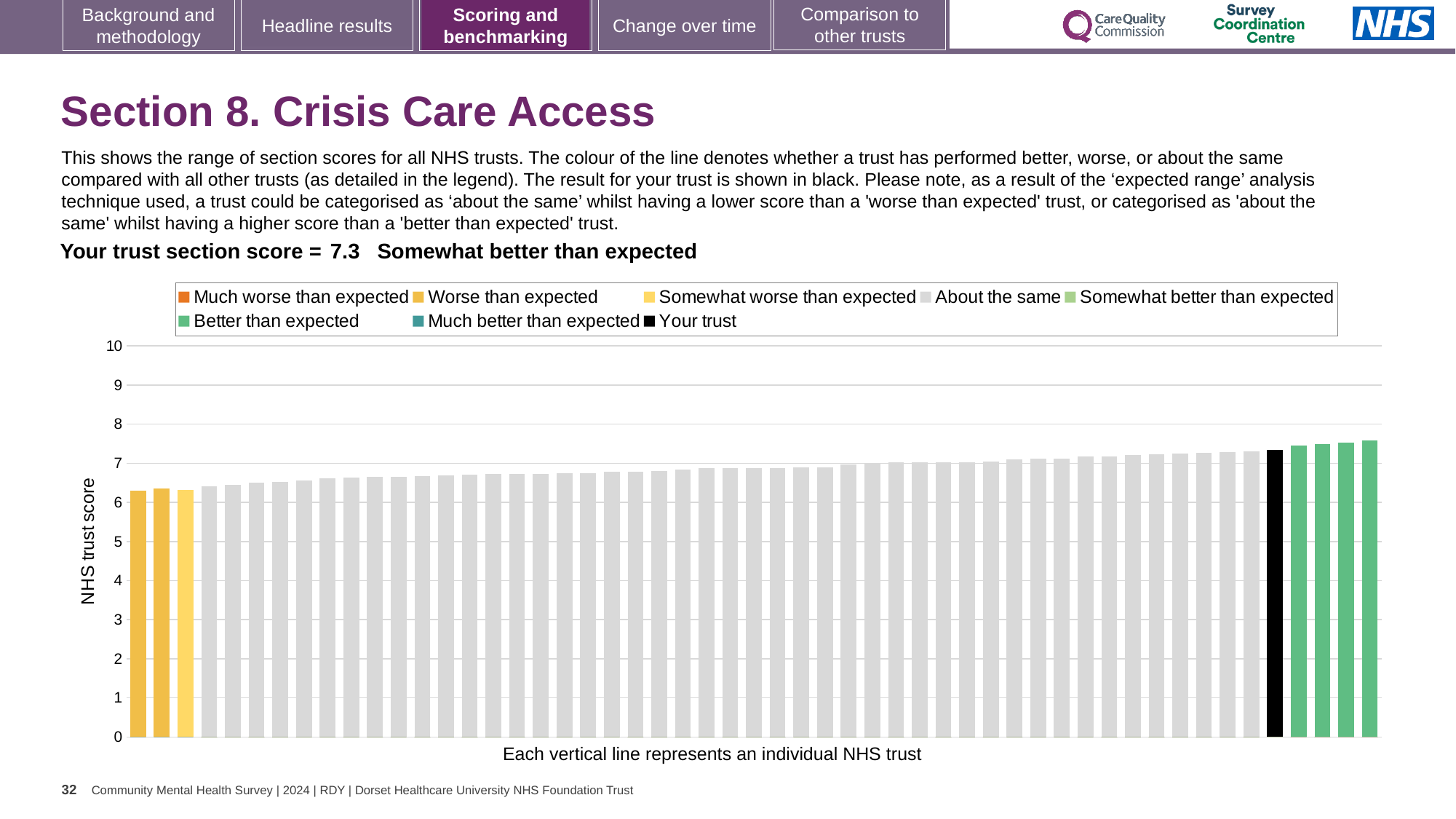
How many entries does the chart legend list? 8 What is the highest value shown on the y axis? 10 What is the section score for your trust shown on the slide? 7.3 Which is larger, the value of the black bar or the value of the leftmost bar? the black bar Is the value of the leftmost bar greater or less than 7? less What kind of chart is shown on the slide? Bar chart Is the value for your trust (the black bar) greater or less than 7? greater Is the value of the rightmost bar greater or less than 7? greater Do the bar values rise or fall from left to right along the x axis? rise What colour is used for the bar representing your trust? Black How is your trust's performance categorised on the slide? Somewhat better than expected What is the label of the y axis? NHS trust score